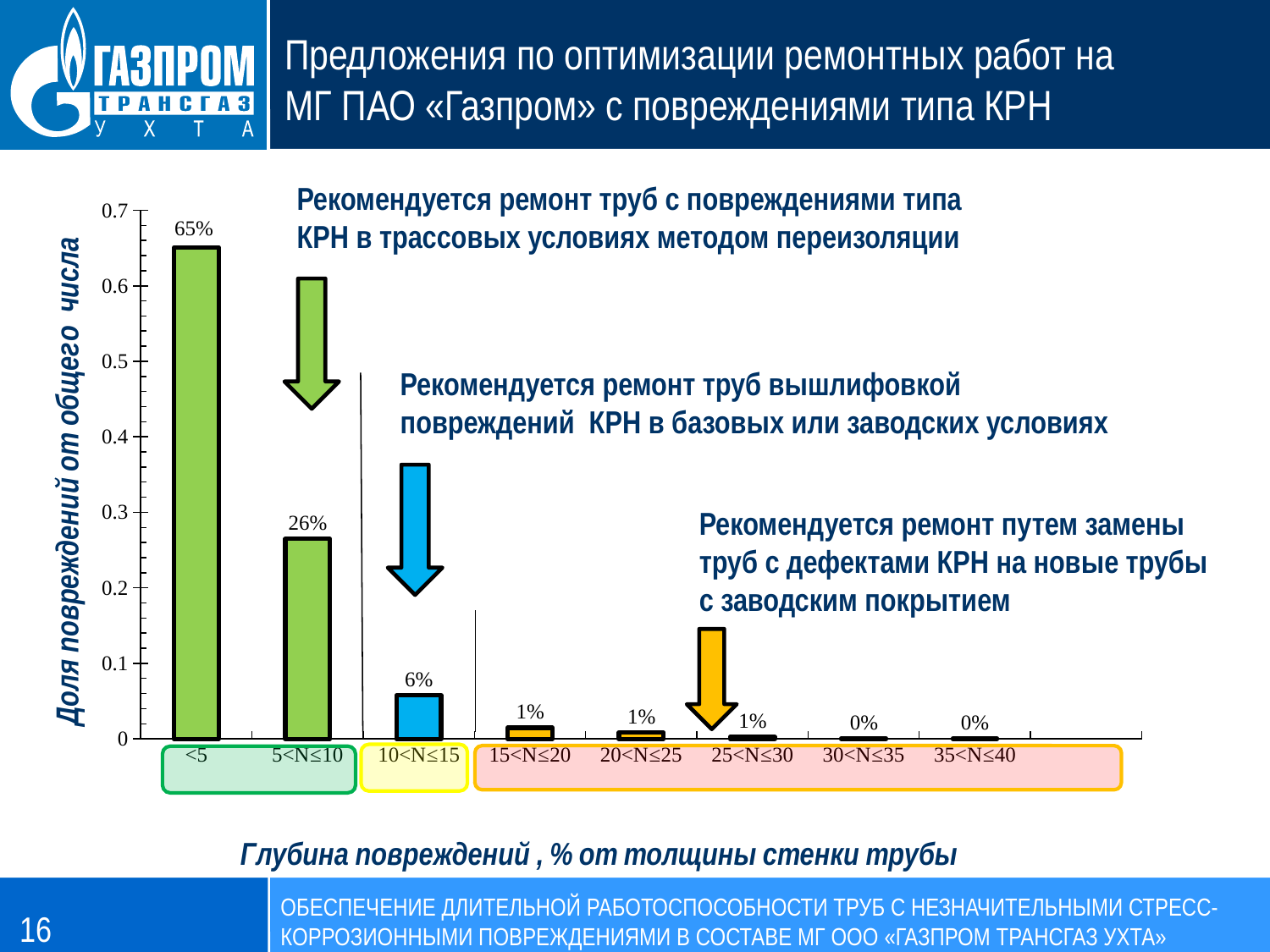
What is the value for the category 15<N≤20? 1% What is the value for the category <5? 65% How many categories are shown on the x axis? 8 What is the value for the category 10<N≤15? 6% Is the value for <5 greater or less than 0.6 on the y axis? greater What is the x-axis label of the chart? Глубина повреждений , % от толщины стенки трубы What kind of chart is shown on the slide? bar chart Which category has the highest value? <5 Which is larger, the value for 5<N≤10 or the value for 10<N≤15? 5<N≤10 What is the difference between the values for <5 and 5<N≤10? 39% What is the value for the category 35<N≤40? 0% What is the value for the category 5<N≤10? 26%